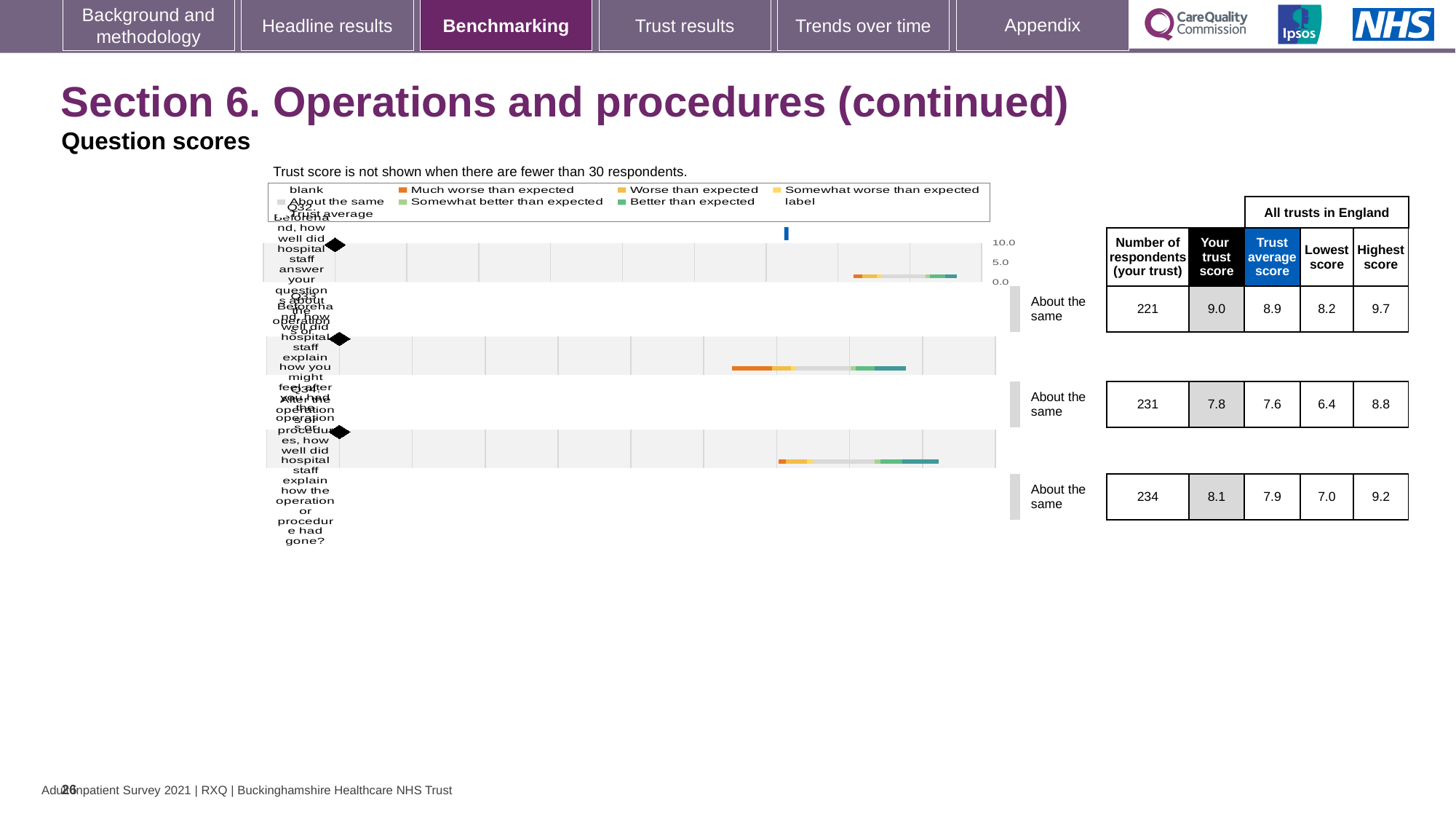
In the table, what is the highest score across all trusts in England for the third question row? 9.2 In the table, what is 'Your trust score' for the first question row? 9.0 In the table, what is the number of respondents for the first question row? 221 What is the difference between 'Your trust score' and the trust average score for the third question row? 0.2 Which question row has the lowest number of respondents in the table? The first row (221) How many question rows are shown in the benchmarking chart and table? 3 For the second question row, is 'Your trust score' larger or smaller than the trust average score? Larger Which question row has the highest 'Your trust score' in the table? The first row (9.0) What is the maximum value shown on the chart's score axis? 10.0 What benchmark category is shown next to each of the three question rows? About the same In the table, what is the lowest score across all trusts in England for the second question row? 6.4 In the table, what is the trust average score for the second question row? 7.6